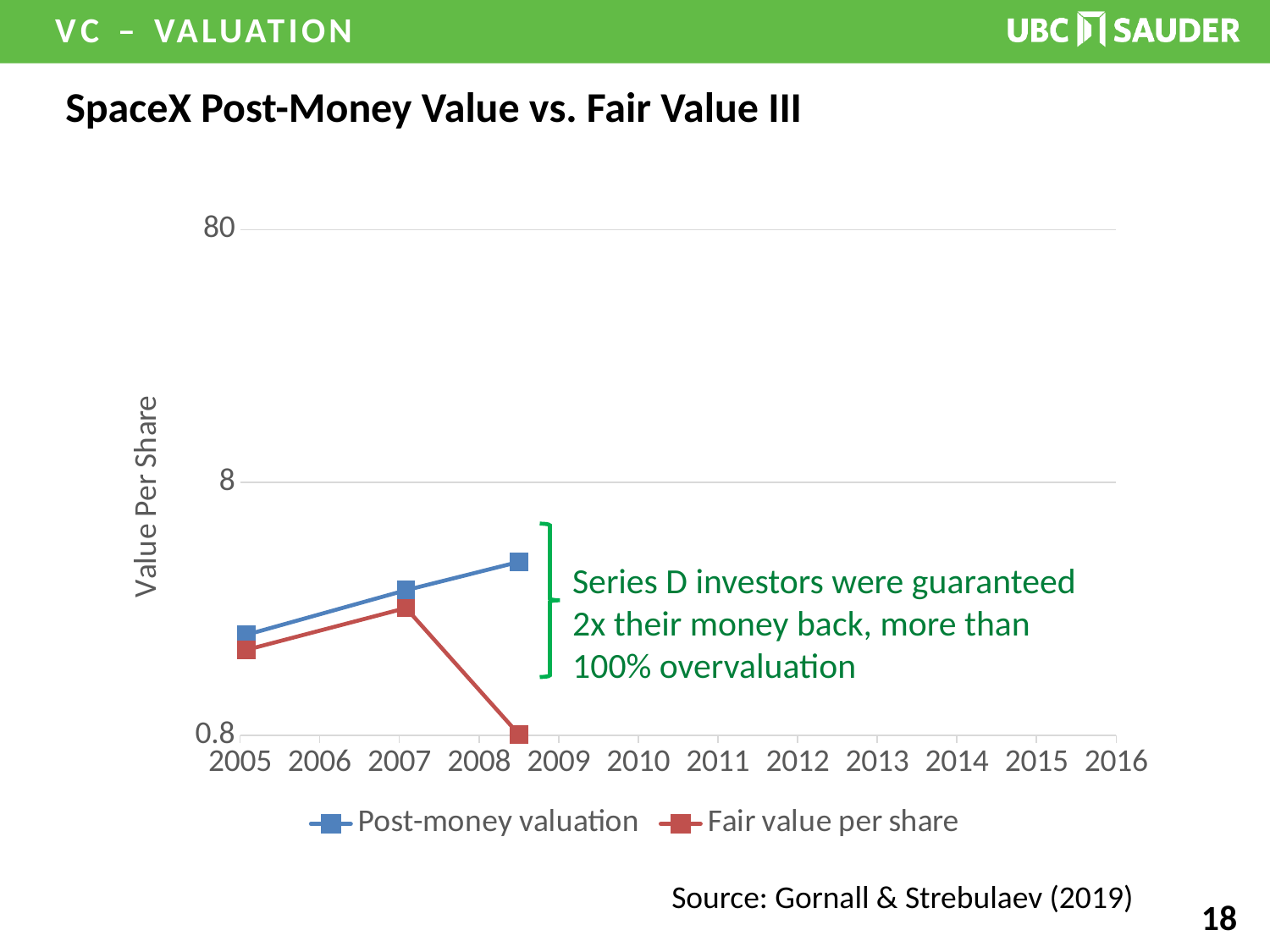
What kind of chart is shown on the slide? line chart At the last plotted point (around 2008), which is larger: the Post-money valuation or the Fair value per share? Post-money valuation How many data points are plotted for the Fair value per share series? 3 How many data points are plotted for the Post-money valuation series? 3 At which plotted point is the Fair value per share lowest? the last point (around 2008) Is the Post-money valuation at its first plotted point (2005) greater or less than 0.8? greater Does the Post-money valuation series rise or fall from 2005 to its last point? rise What is the label on the vertical axis? Value Per Share What are the two series named in the legend? Post-money valuation; Fair value per share Is the Post-money valuation at its last plotted point (around 2008) greater or less than 8? less How many series does the legend list? 2 Does the Fair value per share series rise or fall between its second and third plotted points? fall